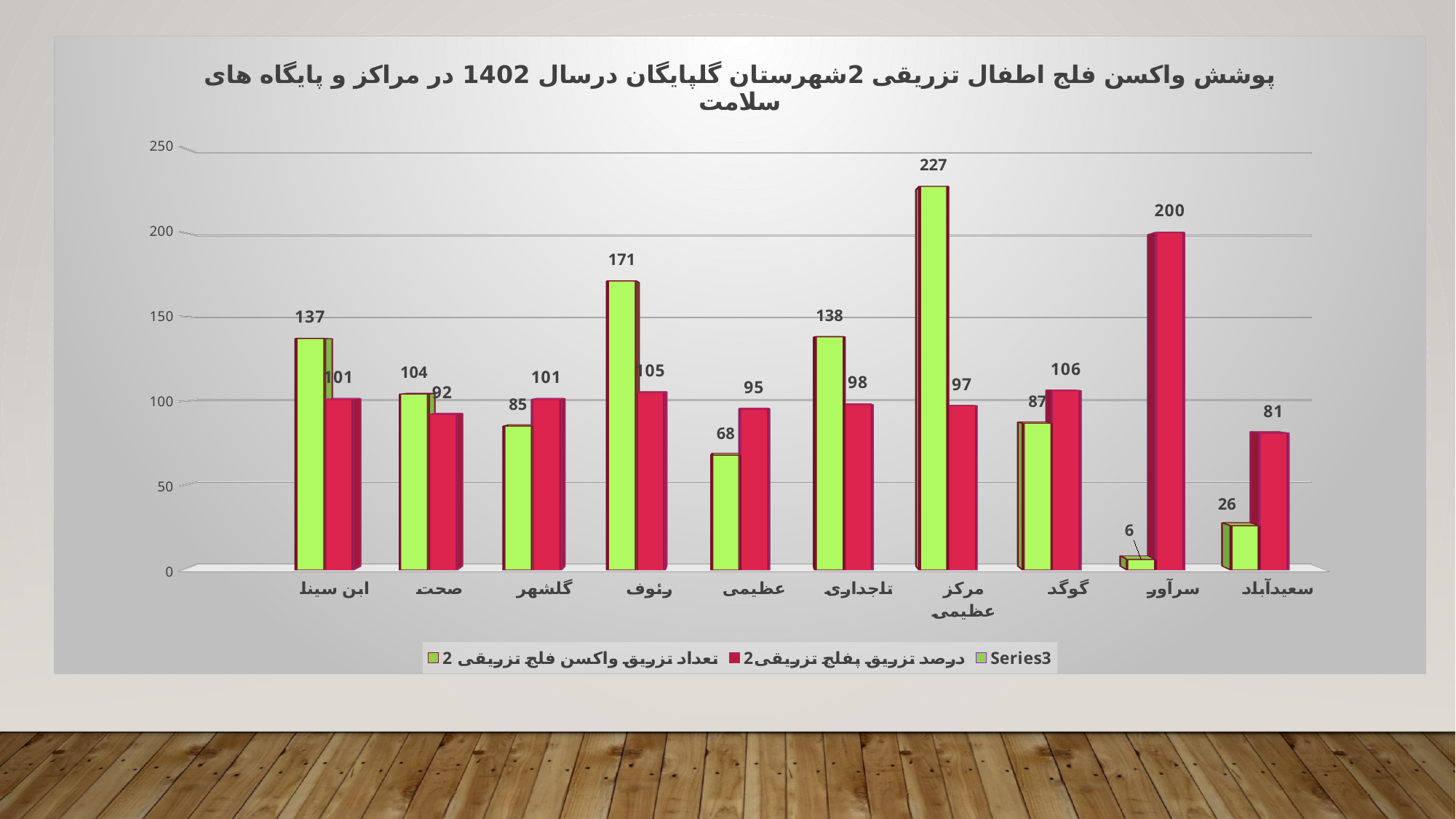
What is the value of درصد تزریق فلج تزریقی 2 for سرآور? 200 What is the difference between the تعداد تزریق واکسن فلج تزریقی 2 values for مرکز عظیمی and رئوف? 56 How many series does the legend list? 3 Which is larger for گلشهر: تعداد تزریق واکسن فلج تزریقی 2 or درصد تزریق فلج تزریقی 2? درصد تزریق فلج تزریقی 2 What is the value of تعداد تزریق واکسن فلج تزریقی 2 for مرکز عظیمی? 227 How many categories are shown on the x axis? 10 What type of chart is shown on the slide? bar chart What colour are the bars for درصد تزریق فلج تزریقی 2? red Which category has the lowest value for درصد تزریق فلج تزریقی 2? سعیدآباد Which category has the highest value for تعداد تزریق واکسن فلج تزریقی 2? مرکز عظیمی What is the value of تعداد تزریق واکسن فلج تزریقی 2 for رئوف? 171 Which category has the lowest value for تعداد تزریق واکسن فلج تزریقی 2? سرآور